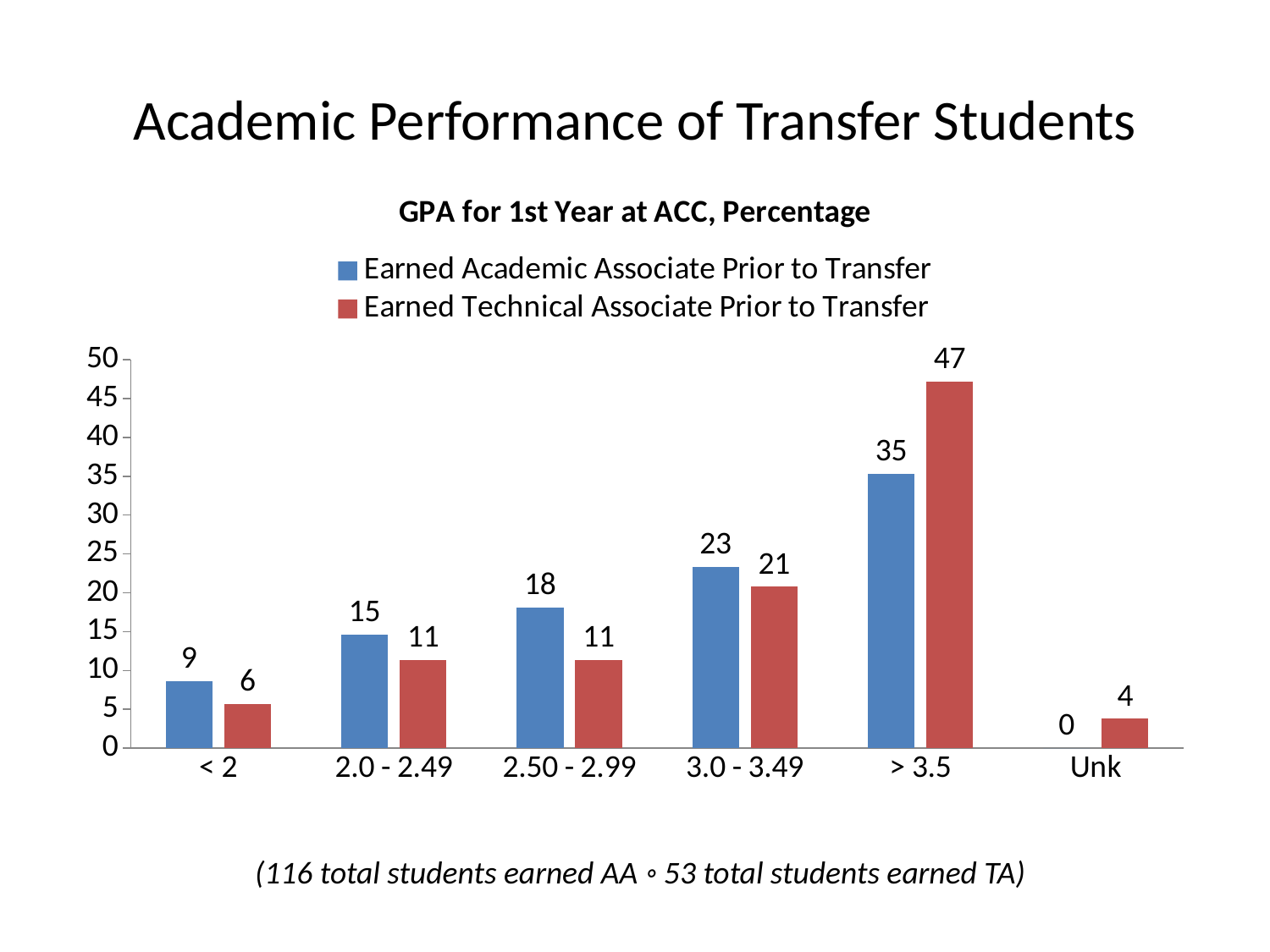
What is the title of the chart? GPA for 1st Year at ACC, Percentage In the 3.0 - 3.49 category, which series has the larger value? Earned Academic Associate Prior to Transfer What is the value for Earned Technical Associate Prior to Transfer in the Unk category? 4 What colour are the bars for Earned Technical Associate Prior to Transfer? Red Which GPA category has the highest value for Earned Technical Associate Prior to Transfer? > 3.5 What is the value for Earned Academic Associate Prior to Transfer in the > 3.5 GPA category? 35 What is the difference between the Earned Technical Associate and Earned Academic Associate values in the > 3.5 category? 12 How many GPA categories are shown on the x axis? 6 How many series does the legend list? 2 Which GPA category has the lowest value for Earned Academic Associate Prior to Transfer? Unk What is the value for Earned Technical Associate Prior to Transfer in the 2.0 - 2.49 GPA category? 11 What kind of chart is shown on the slide? Bar chart